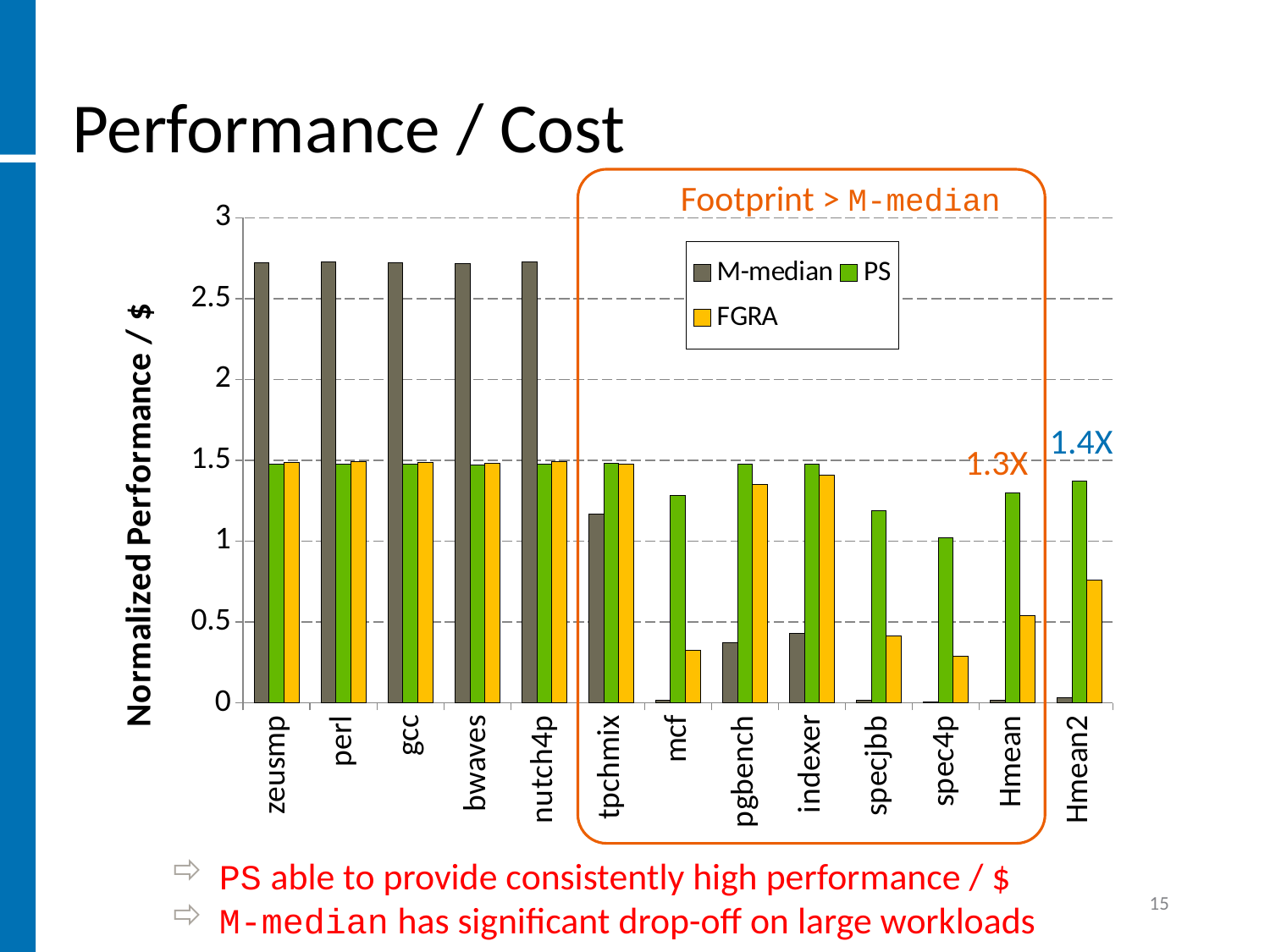
What is the y-axis label of the chart? Normalized Performance / $ How many series does the legend list? 3 Is the FGRA value for Hmean2 greater or less than 0.5? greater How many categories are shown along the x axis? 13 For zeusmp, which is larger: the M-median value or the PS value? M-median Which series are listed in the legend? M-median, PS, FGRA What kind of chart is shown on the slide? bar chart For mcf, which is larger: the PS value or the FGRA value? PS Is the M-median value for zeusmp greater or less than 2.5? greater Is the PS value for mcf greater or less than 1? greater Does the M-median value rise or fall from nutch4p to tpchmix? fall